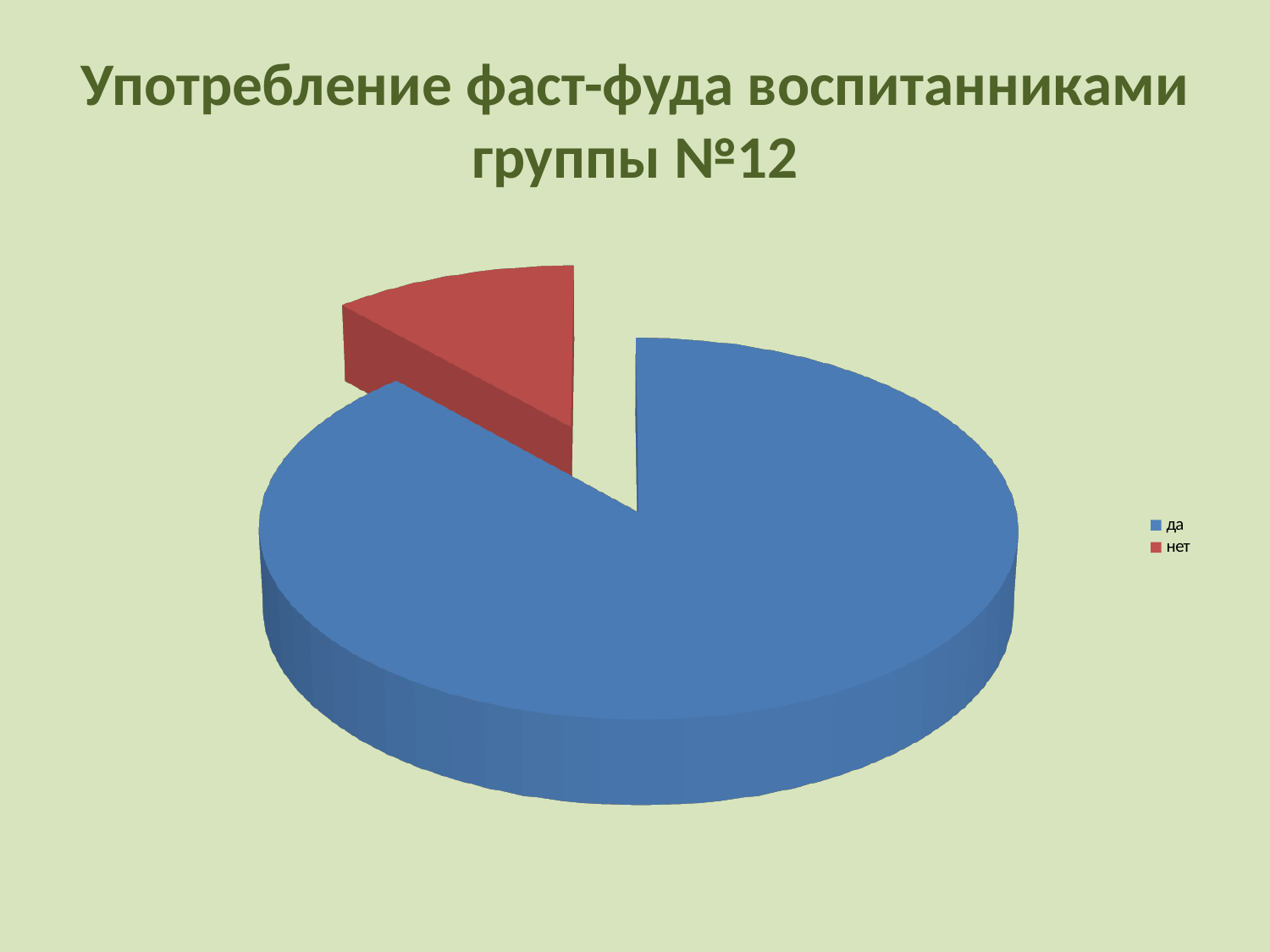
How many slices does the pie chart have? 2 How many entries does the legend list? 2 What kind of chart is shown on the slide? pie chart What colour is the slice for "нет"? red What is the title of the chart on the slide? Употребление фаст-фуда воспитанниками группы №12 Which slice is larger, "да" or "нет"? да Which category has the largest slice of the pie? да Which category has the smallest slice of the pie? нет